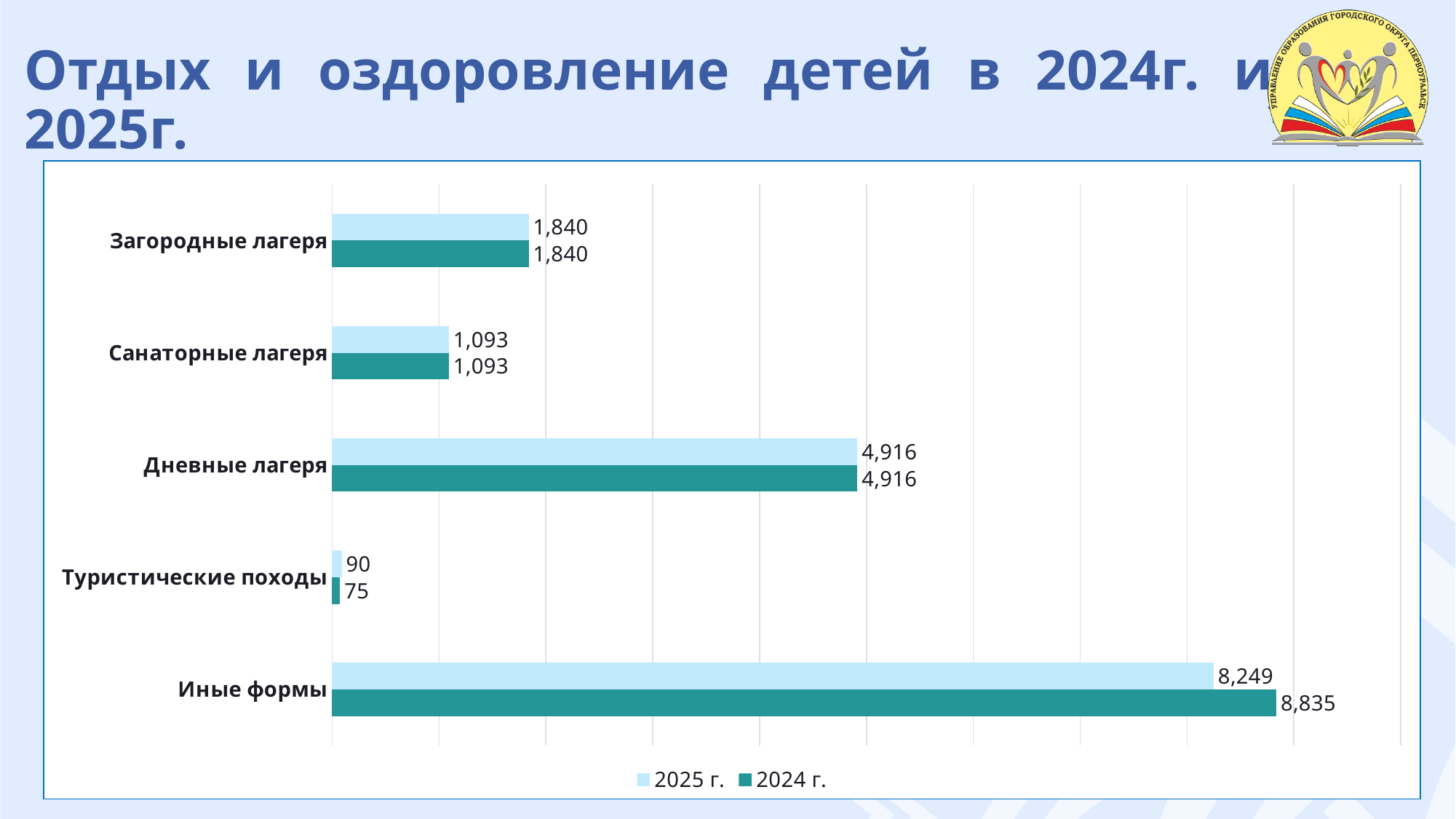
What is the value for Иные формы in 2025 г.? 8,249 What is the value for Иные формы in 2024 г.? 8,835 For Туристические походы, which year has the larger value, 2024 г. or 2025 г.? 2025 г. Which category has the lowest value in 2025 г.? Туристические походы Which legend entry is shown in the darker teal colour? 2024 г. What is the difference between the 2024 г. and 2025 г. values for Иные формы? 586 How many series does the legend list? 2 What type of chart is shown on the slide? bar chart What is the value for Туристические походы in 2025 г.? 90 What is the value for Дневные лагеря in 2024 г.? 4,916 Which category has the highest value in 2024 г.? Иные формы How many categories are shown on the chart? 5